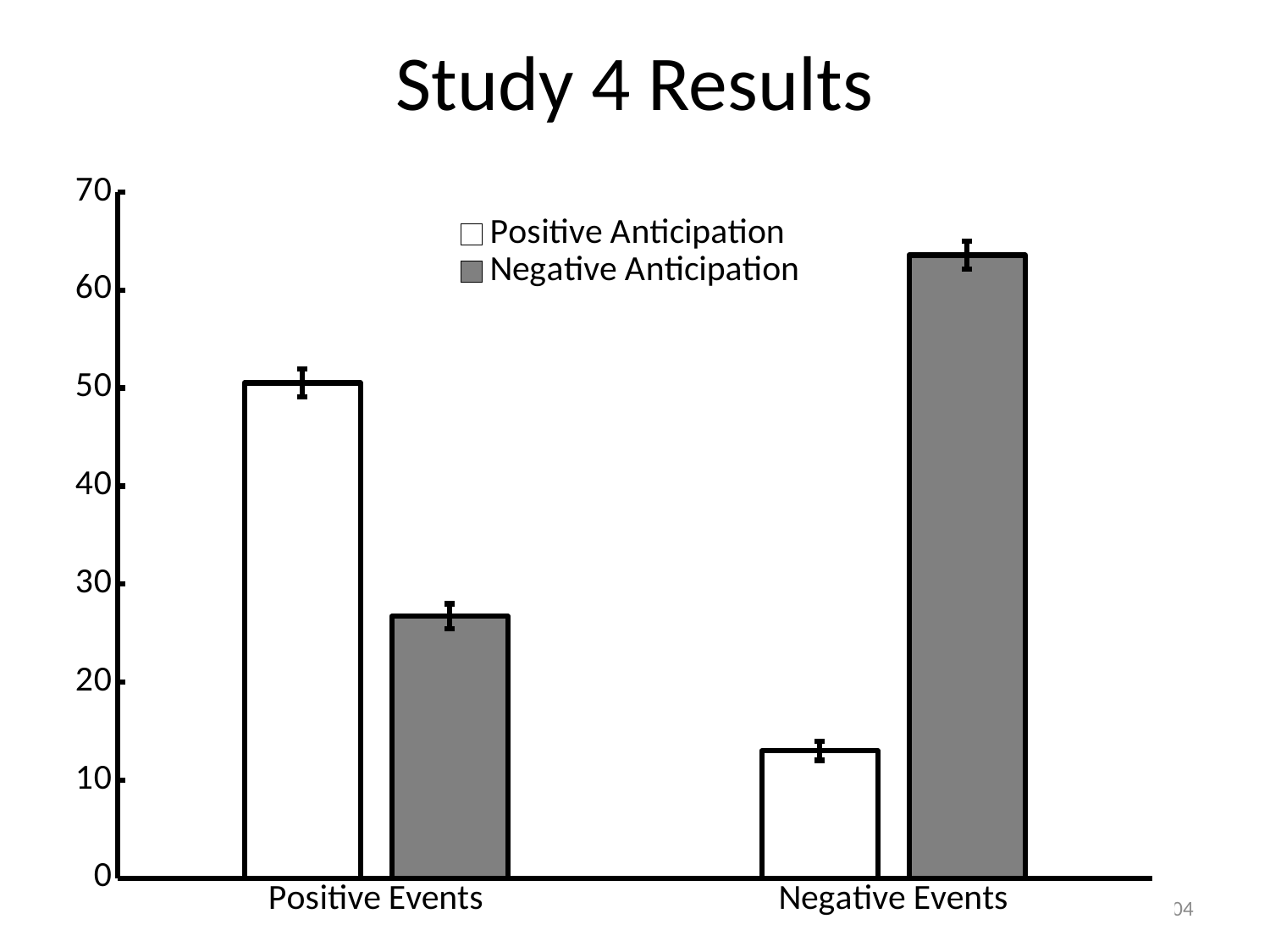
For Positive Events, which is larger: Positive Anticipation or Negative Anticipation? Positive Anticipation How many event categories are shown on the x axis? 2 Which series is shown with grey bars? Negative Anticipation What kind of chart is shown on the slide? bar chart Which bar is the tallest in the chart? Negative Anticipation for Negative Events For Negative Events, which is larger: Positive Anticipation or Negative Anticipation? Negative Anticipation What is the title of the chart? Study 4 Results Is the value for Positive Anticipation for Positive Events greater or less than 40? greater How many series does the legend list? 2 Which bar is the shortest in the chart? Positive Anticipation for Negative Events Is the value for Negative Anticipation for Positive Events greater or less than 30? less Is the value for Negative Anticipation for Negative Events greater or less than 60? greater